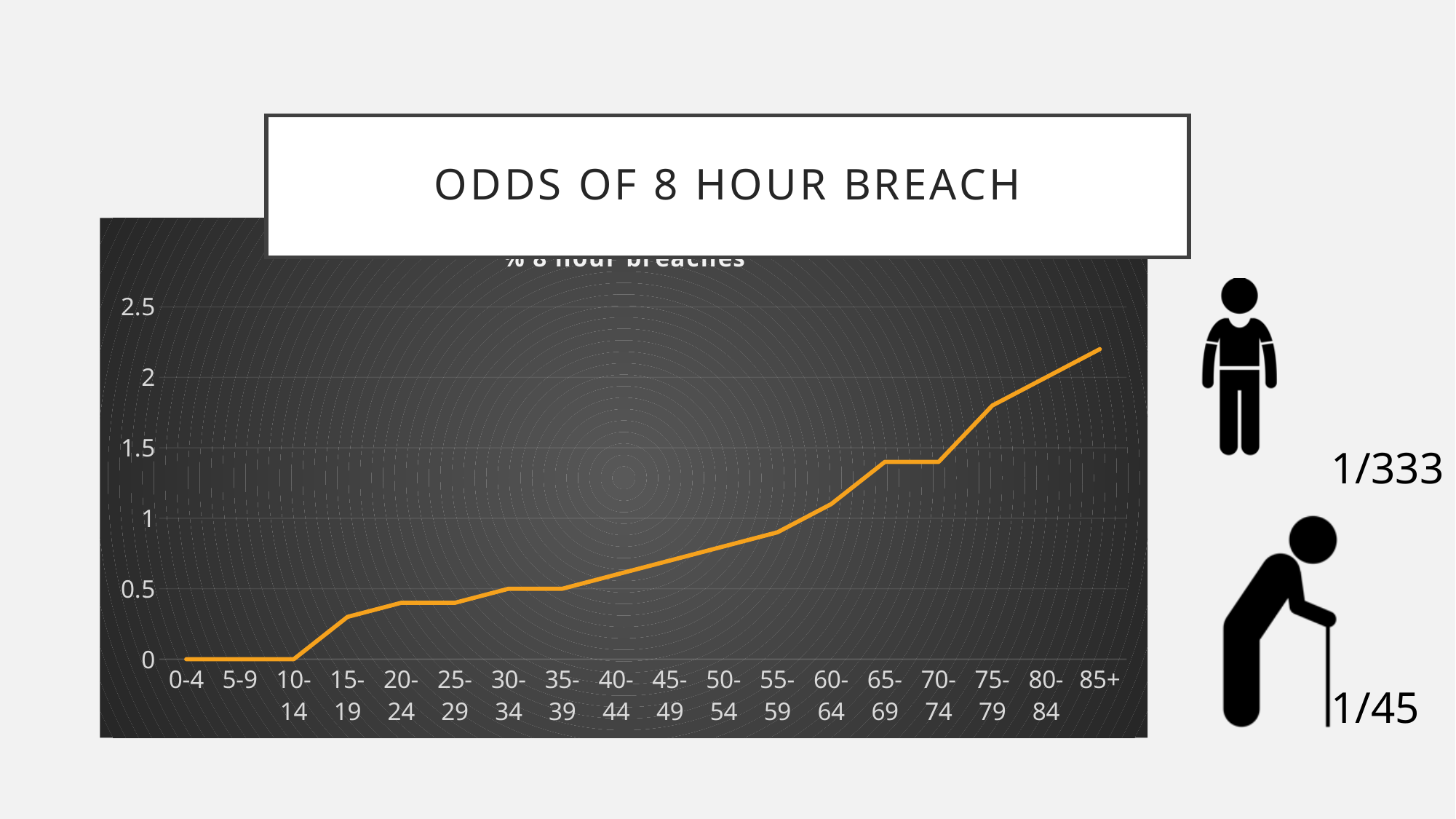
What kind of chart is shown on the slide? line chart How many age categories are shown on the x axis of the chart? 18 What is the value for the 10-14 age category? 0 Which has the larger value, 60-64 or 40-44? 60-64 Is the value for 65-69 greater or less than 1? greater Is the value for 85+ greater or less than 2? greater Is the value for 30-34 greater or less than 1? less What is the value for the 0-4 age category? 0 Do the values generally rise or fall as age increases along the x axis? rise What is the title shown in the large text box above the chart? ODDS OF 8 HOUR BREACH Which age category has the highest value in the chart? 85+